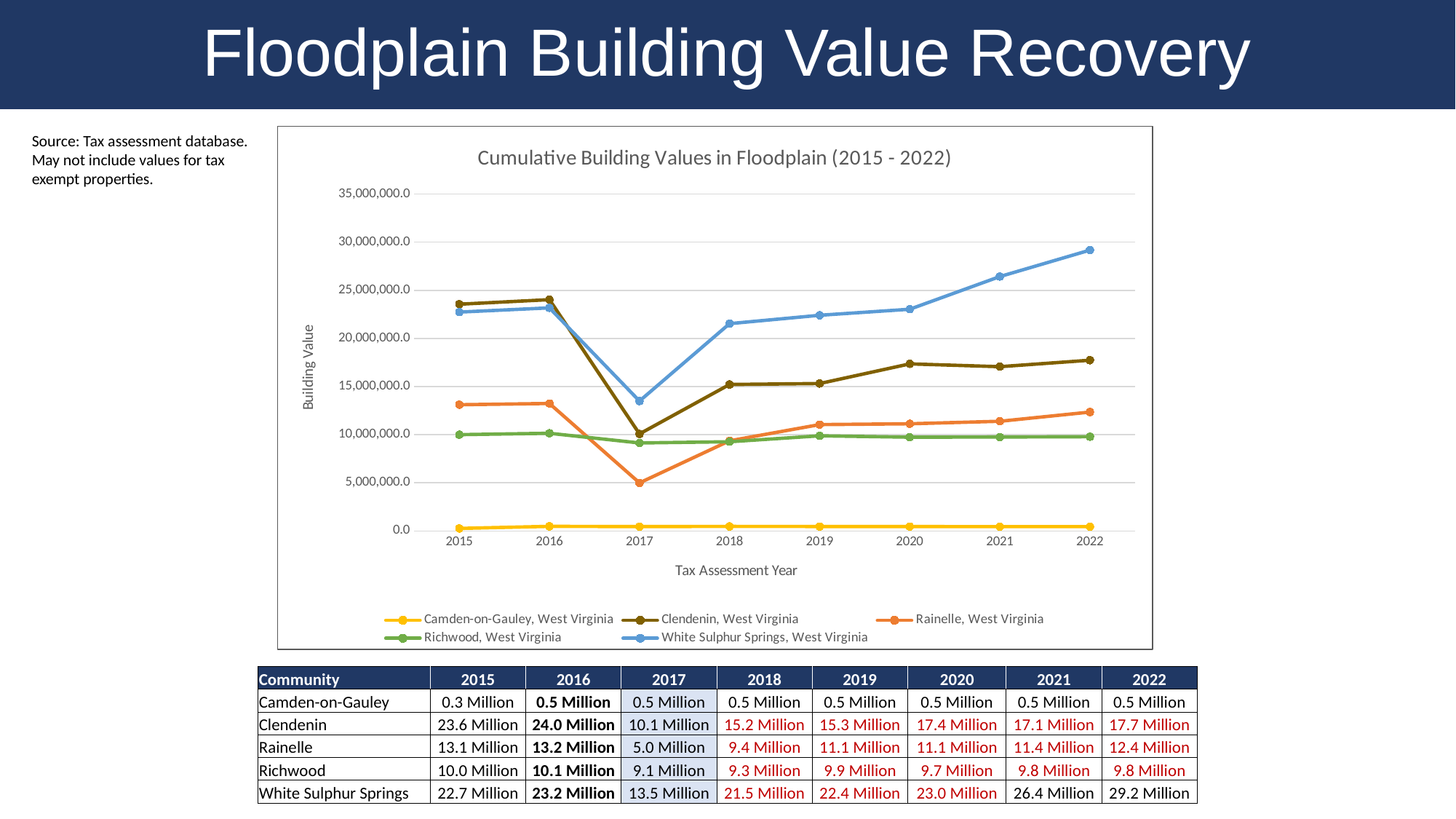
What is the building value for White Sulphur Springs in 2022? 29.2 Million Which community had the highest building value in 2022? White Sulphur Springs Which had a larger building value in 2015, Clendenin or White Sulphur Springs? Clendenin How many tax assessment years are plotted along the x axis? 8 Which community had the lowest building value in 2017? Camden-on-Gauley What is the building value for Clendenin in 2017? 10.1 Million What is the title of the chart? Cumulative Building Values in Floodplain (2015 - 2022) What is the difference between Clendenin's building value in 2016 and in 2017? 13.9 Million Does the building value for White Sulphur Springs rise or fall from 2017 to 2022? rise Is the value for White Sulphur Springs in 2021 greater or less than 25,000,000.0? greater How many series does the chart legend list? 5 What type of chart is shown on the slide? line chart